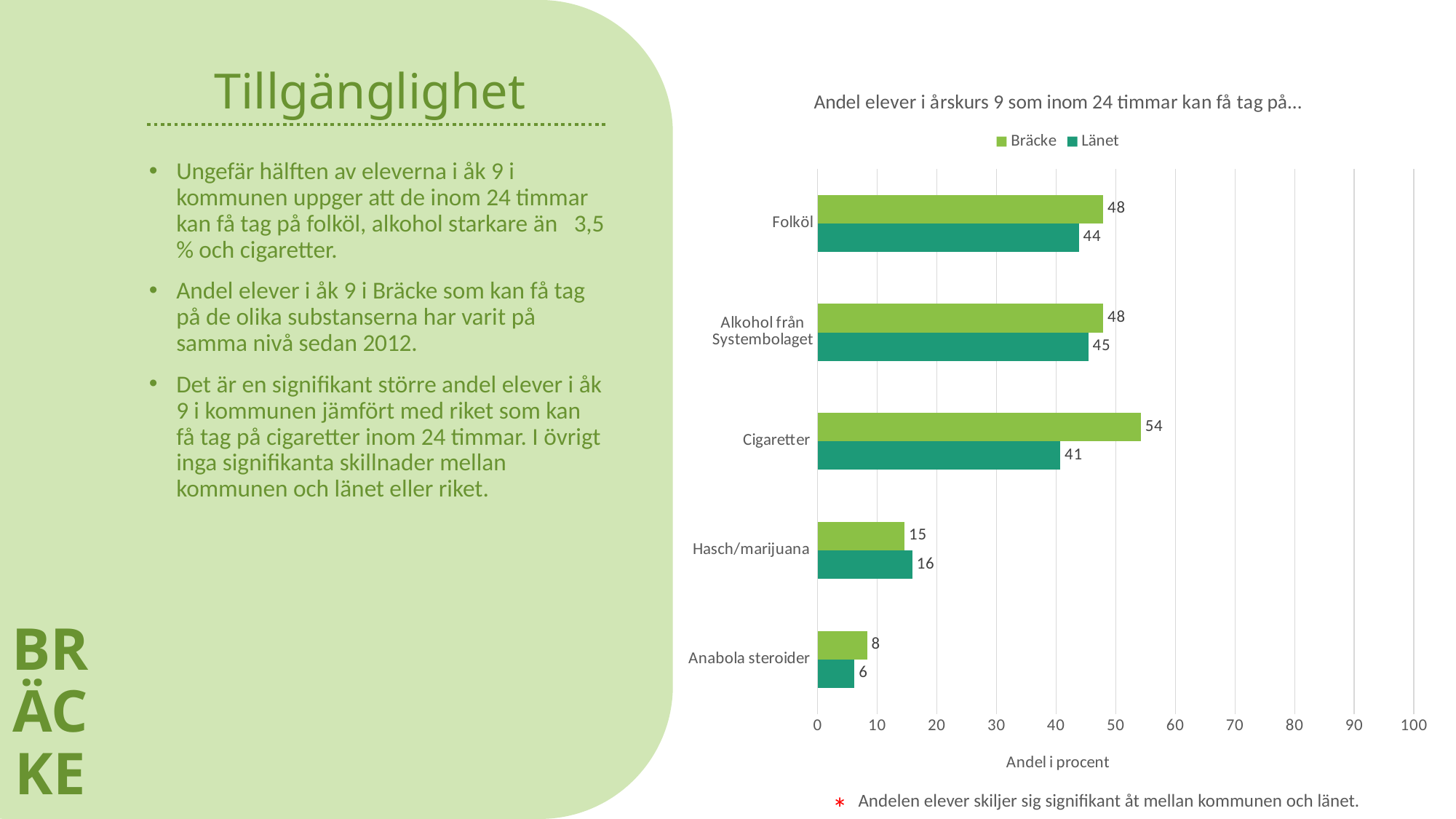
Which category has the lowest value for Länet? Anabola steroider What is the value for Bräcke for Cigaretter? 54 How many categories are shown on the chart? 5 What is the difference between the Bräcke and Länet values for Cigaretter? 13 What is the x-axis title of the chart? Andel i procent What is the value for Länet for Hasch/marijuana? 16 Which is larger for Hasch/marijuana, the Bräcke value or the Länet value? Länet What is the value for Länet for Folköl? 44 Which category has the highest value for Bräcke? Cigaretter How many series does the legend list? 2 What kind of chart is shown on the slide? Bar chart What is the value for Bräcke for Anabola steroider? 8